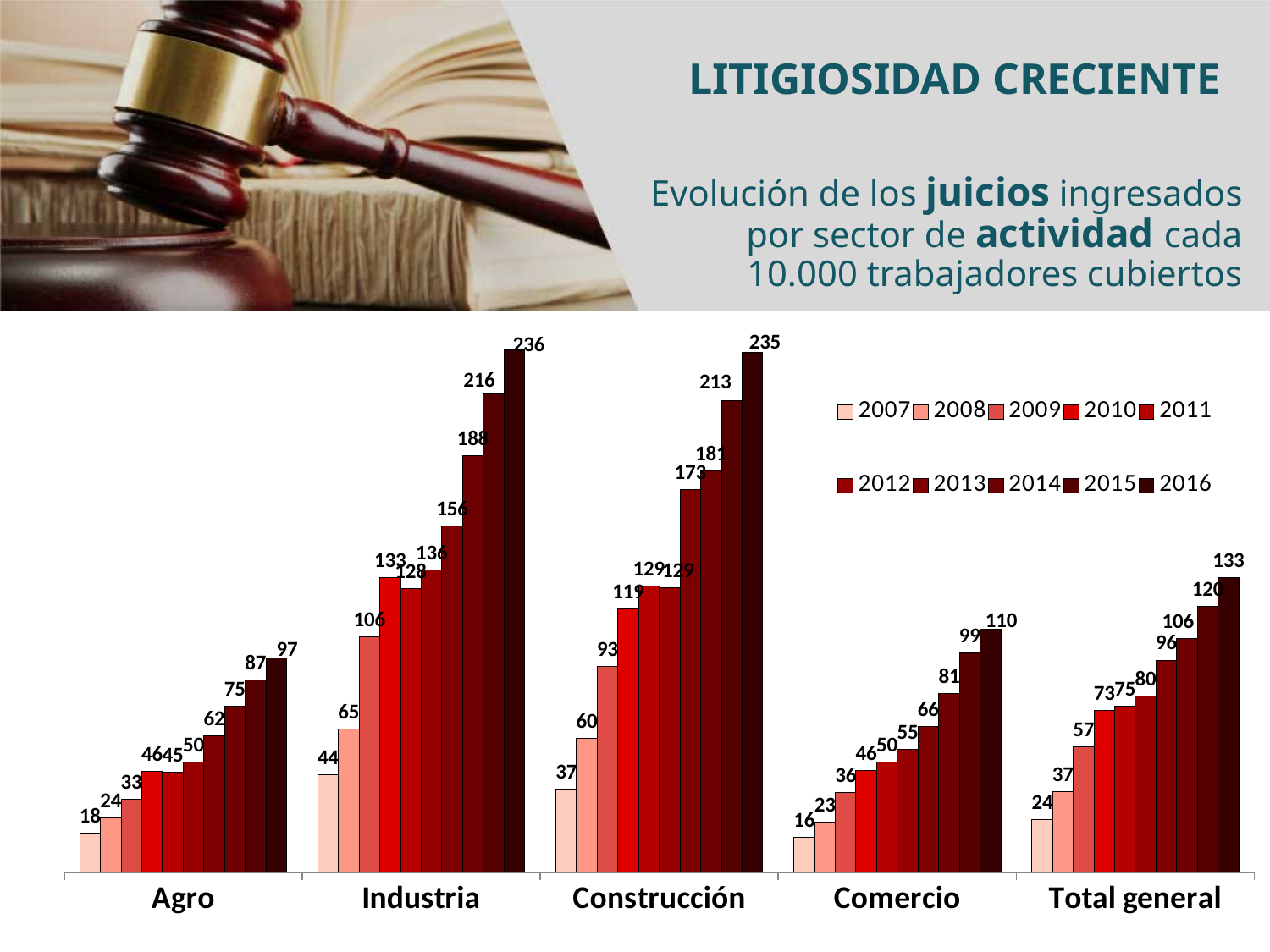
How many sector categories are shown on the x axis? 5 What is the value for Agro in 2007? 18 What is the value for Industria in 2016? 236 What is the value for Total general in 2016? 133 Which is larger, the 2016 value for Agro or the 2016 value for Comercio? Comercio Which sector has the lowest value in 2007? Comercio What kind of chart is shown on the slide? Bar chart How many series (years) does the legend list? 10 What is the value for Comercio in 2012? 55 Which sector has the highest value in 2016? Industria What is the difference between the 2016 and 2007 values for Construcción? 198 Do the values for Total general rise or fall from 2007 to 2016? Rise